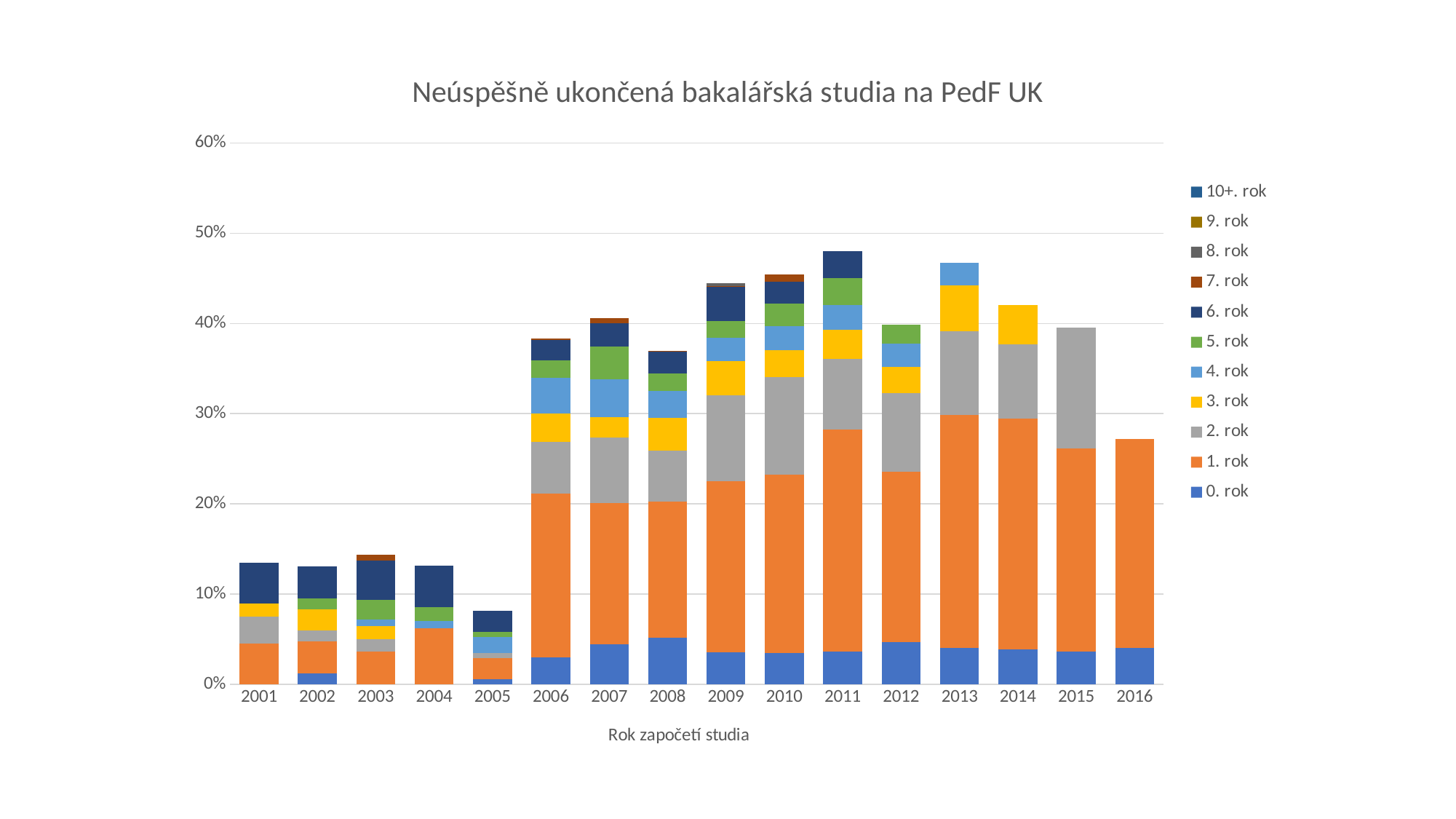
Is the total for 2016 greater or less than 30%? less What is the title of the chart? Neúspěšně ukončená bakalářská studia na PedF UK Which year has the highest total stacked bar? 2011 Is the total for 2005 greater or less than 10%? less What is the label of the x axis? Rok započetí studia Which year has the larger total bar, 2011 or 2012? 2011 How many years (categories) are shown on the x axis? 16 Do the total bar heights rise or fall from 2013 to 2016? fall What kind of chart is shown on the slide? Stacked bar chart How many series does the legend list? 11 Is the total for 2013 greater or less than 40%? greater Which year has the lowest total stacked bar? 2005